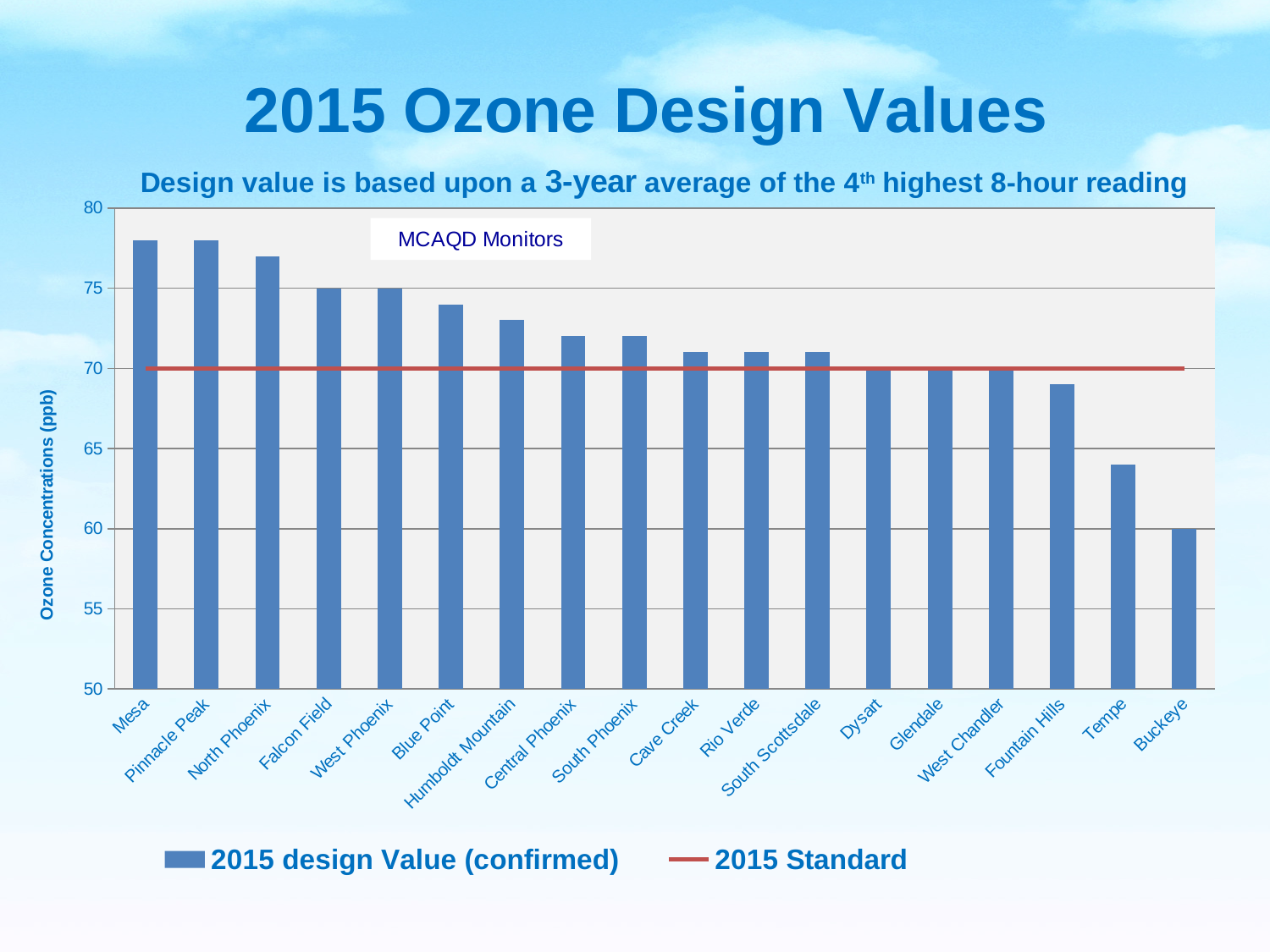
What is the 2015 design value for Falcon Field in ppb? 75 What kind of chart is shown on the slide? bar chart Which has the larger design value, Mesa or Buckeye? Mesa Which site has the lowest 2015 design value? Buckeye Do the design values rise or fall moving from left to right along the x axis? fall Is the value for Fountain Hills greater or less than 70? less How many entries does the legend list? 2 How many monitoring sites are shown along the x axis? 18 What is the 2015 design value for Buckeye in ppb? 60 Is the value for Mesa greater or less than 75? greater Is the value for Tempe greater or less than 65? less What ozone concentration does the 2015 Standard line mark? 70